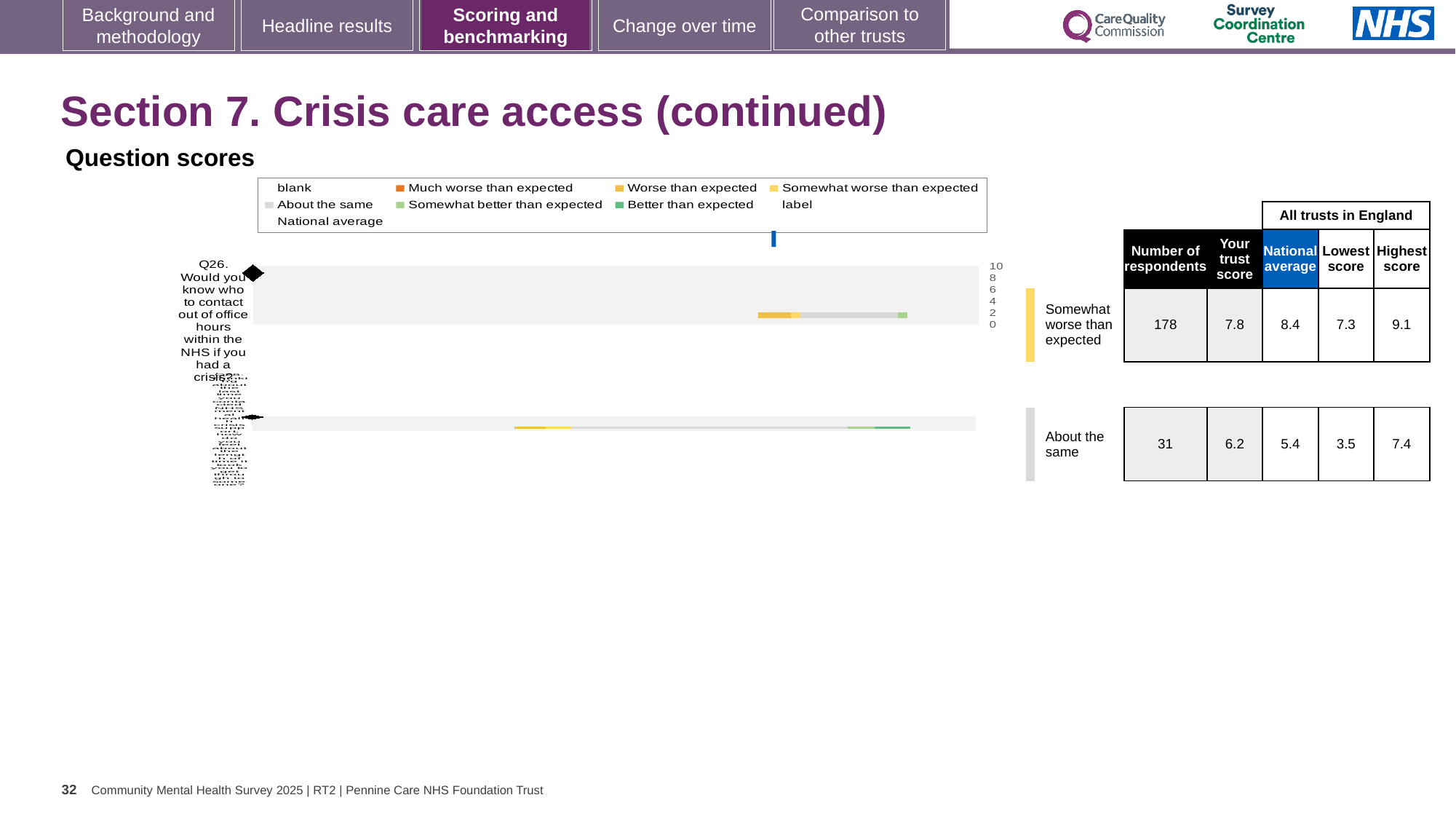
In the table beside the chart, what is the 'Your trust score' for the second question row, labelled 'About the same'? 6.2 Which benchmark category is shown next to the Q26 bar in the 'Question scores' chart? Somewhat worse than expected In the table beside the chart, what is the lowest score among all trusts in England for Q26? 7.3 For Q26, which is larger: the trust score or the national average? national average In the table beside the chart, what is the 'Your trust score' for Q26? 7.8 In the table beside the chart, what is the national average for Q26? 8.4 In the chart legend, what colour marks 'Much worse than expected'? orange How many question rows are plotted in the 'Question scores' chart? 2 For Q26, what is the difference between the national average and the trust score? 0.6 In the table beside the chart, what is the highest score among all trusts in England for Q26? 9.1 In the table beside the chart, how many respondents are listed for Q26? 178 What kind of chart is shown under 'Question scores'? bar chart